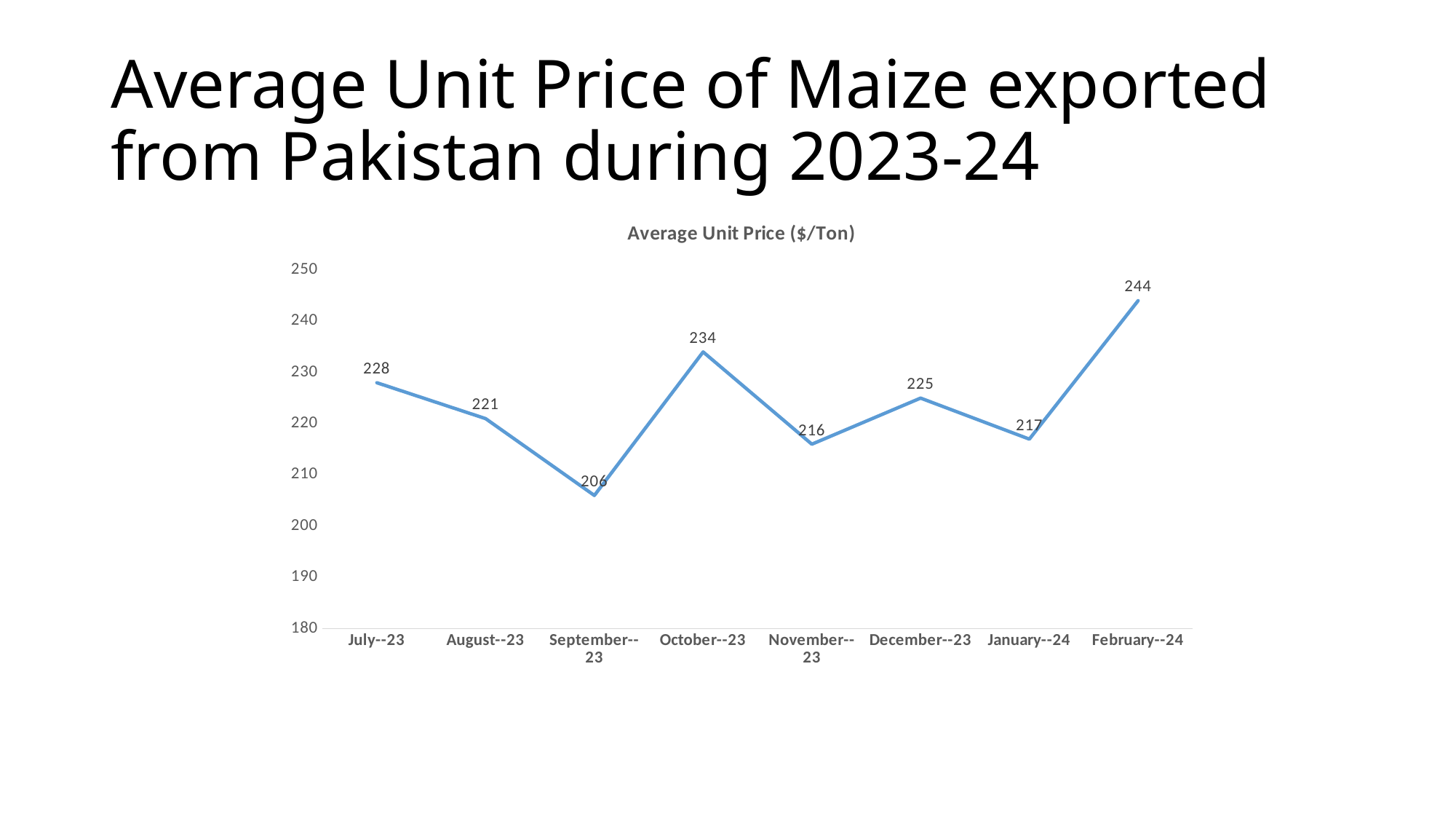
Which month has the highest average unit price? February--24 Which is higher, the average unit price in December--23 or November--23? December--23 Which month has the lowest average unit price? September--23 What is the average unit price for October--23? 234 What kind of chart is shown on the slide? line chart What is the difference between the average unit price in February--24 and September--23? 38 What is the average unit price for January--24? 217 What is the title of the chart? Average Unit Price ($/Ton) What is the difference between the average unit price in July--23 and August--23? 7 Is the value for October--23 greater or less than 230? greater What is the average unit price for September--23? 206 How many months are plotted on the chart? 8